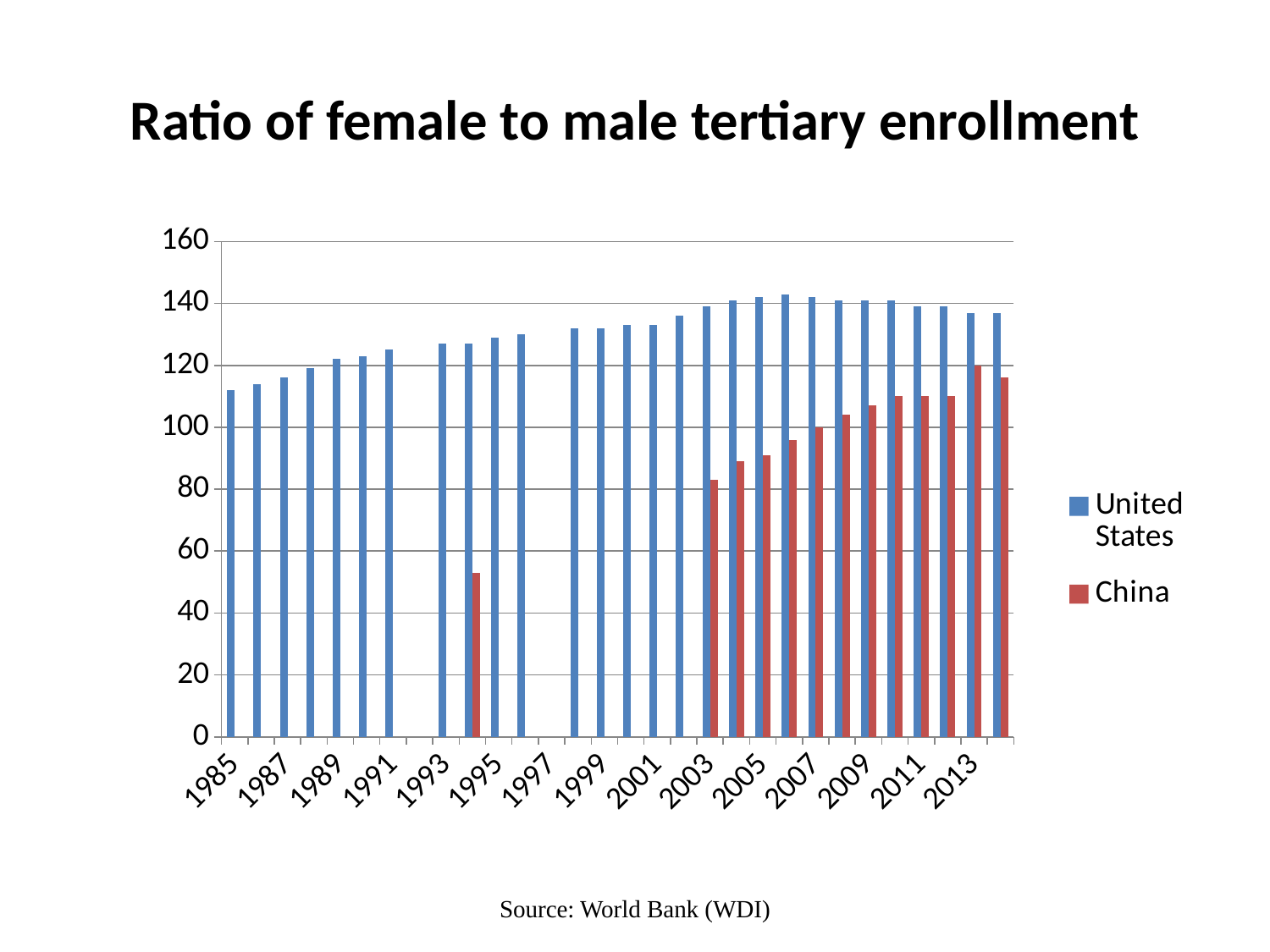
Is the value for the United States in 1985 greater or less than 120? less Is the value for China in 1994 greater or less than 60? less What is the title of the chart? Ratio of female to male tertiary enrollment How many series does the legend list? 2 Which two series are shown in the legend? United States and China In 2013, which series has the larger value, United States or China? United States For China, which year has the larger value, 2003 or 2013? 2013 Is the value for the United States in 2006 greater or less than 140? greater What kind of chart is shown on the slide? bar chart Do the values for China rise or fall from 2003 to 2013? rise